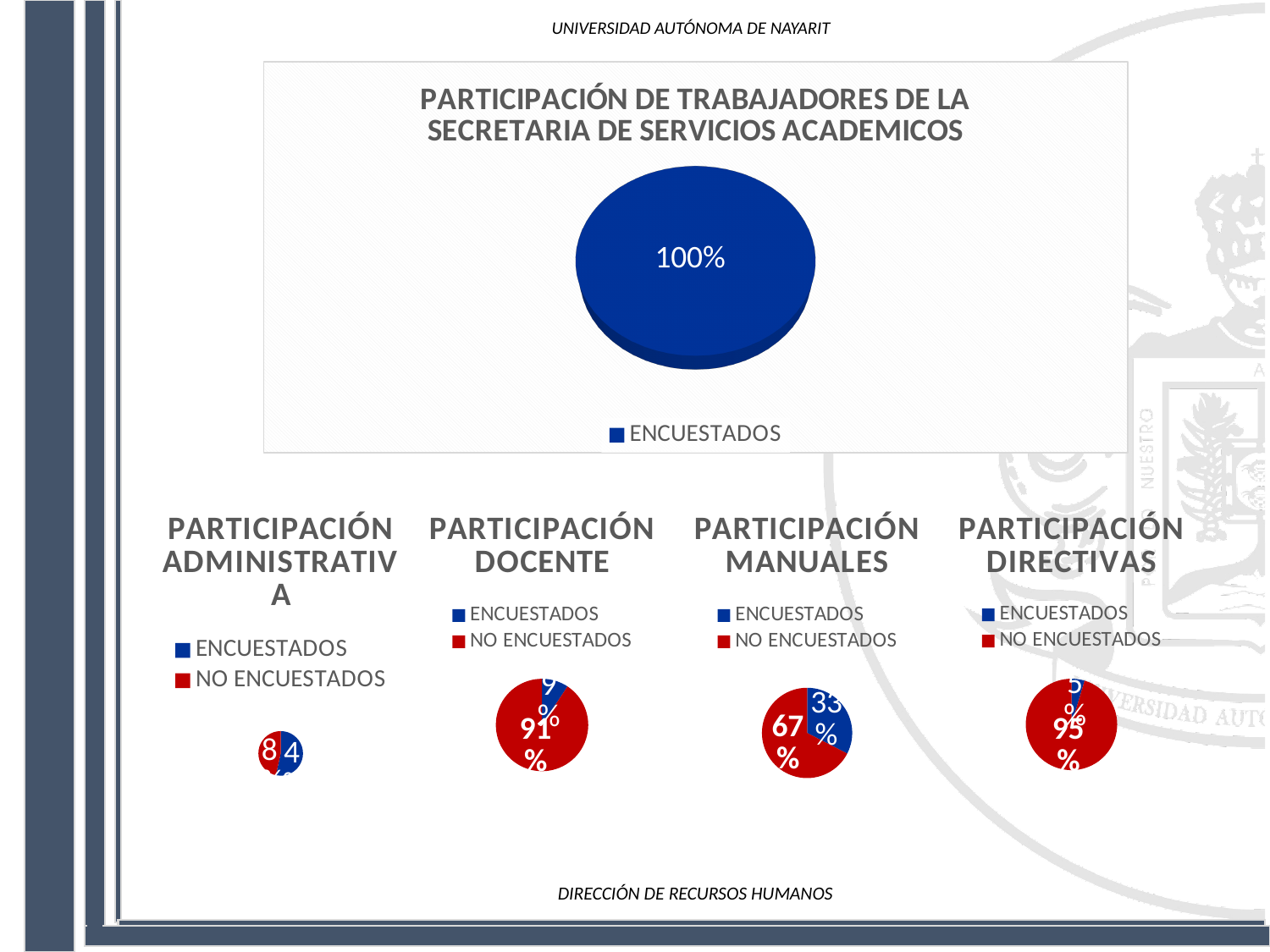
In the chart titled "PARTICIPACIÓN DOCENTE", what percentage is shown for NO ENCUESTADOS? 91% In the chart titled "PARTICIPACIÓN DIRECTIVAS", what percentage is shown for NO ENCUESTADOS? 95% In the chart titled "PARTICIPACIÓN MANUALES", what is the difference between the NO ENCUESTADOS and ENCUESTADOS percentages? 34% In the chart titled "PARTICIPACIÓN DOCENTE", what percentage is shown for ENCUESTADOS? 9% In the chart titled "PARTICIPACIÓN MANUALES", what percentage is shown for ENCUESTADOS? 33% In the chart titled "PARTICIPACIÓN MANUALES", what percentage is shown for NO ENCUESTADOS? 67% How many entries does the legend of the chart titled "PARTICIPACIÓN DE TRABAJADORES DE LA SECRETARIA DE SERVICIOS ACADEMICOS" list? 1 How many entries does the legend of the chart titled "PARTICIPACIÓN DOCENTE" list? 2 What kind of chart is the chart titled "PARTICIPACIÓN DE TRABAJADORES DE LA SECRETARIA DE SERVICIOS ACADEMICOS"? Pie chart In the chart titled "PARTICIPACIÓN DIRECTIVAS", which slice is larger, ENCUESTADOS or NO ENCUESTADOS? NO ENCUESTADOS In the chart titled "PARTICIPACIÓN DE TRABAJADORES DE LA SECRETARIA DE SERVICIOS ACADEMICOS", what percentage is shown for ENCUESTADOS? 100% In the chart titled "PARTICIPACIÓN MANUALES", what colour represents NO ENCUESTADOS? Red